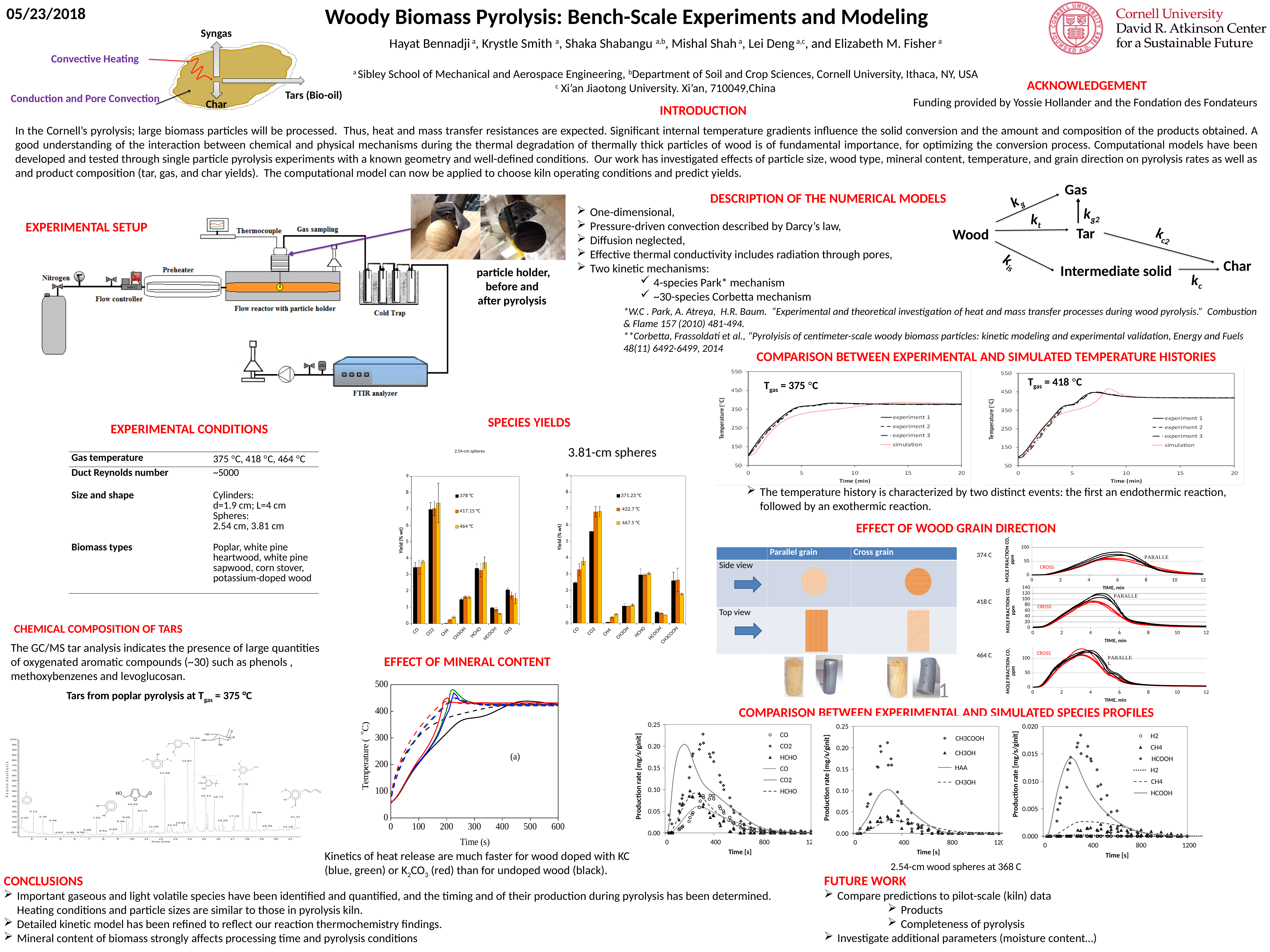
In the '3.81-cm spheres' species yields chart, is the CO yield at 371.23 °C greater or less than 3? less What is the maximum value shown on the x axis of the 'Effect of mineral content' chart? 600 In the '3.81-cm spheres' species yields chart, is the CO2 yield larger than the CH3OH yield? Yes In the leftmost chart under 'Comparison between experimental and simulated species profiles', which species reaches the highest peak production rate? CO2 How many series does the legend list in the temperature history chart for Tgas = 375 °C? 4 In the '2.54-cm spheres' species yields chart, which species has the lowest yield? CH4 How many series does the legend of the '3.81-cm spheres' species yields chart list? 3 In the '2.54-cm spheres' species yields chart, is the CO2 yield at 464 °C greater or less than 6? greater In the '2.54-cm spheres' species yields chart, which species has the highest yield? CO2 What kind of chart is the '2.54-cm spheres' species yields chart? bar chart What are the legend entries of the '3.81-cm spheres' species yields chart? 371.23 °C, 422.7 °C, 467.5 °C How many species categories are shown on the x axis of the '2.54-cm spheres' species yields chart? 7